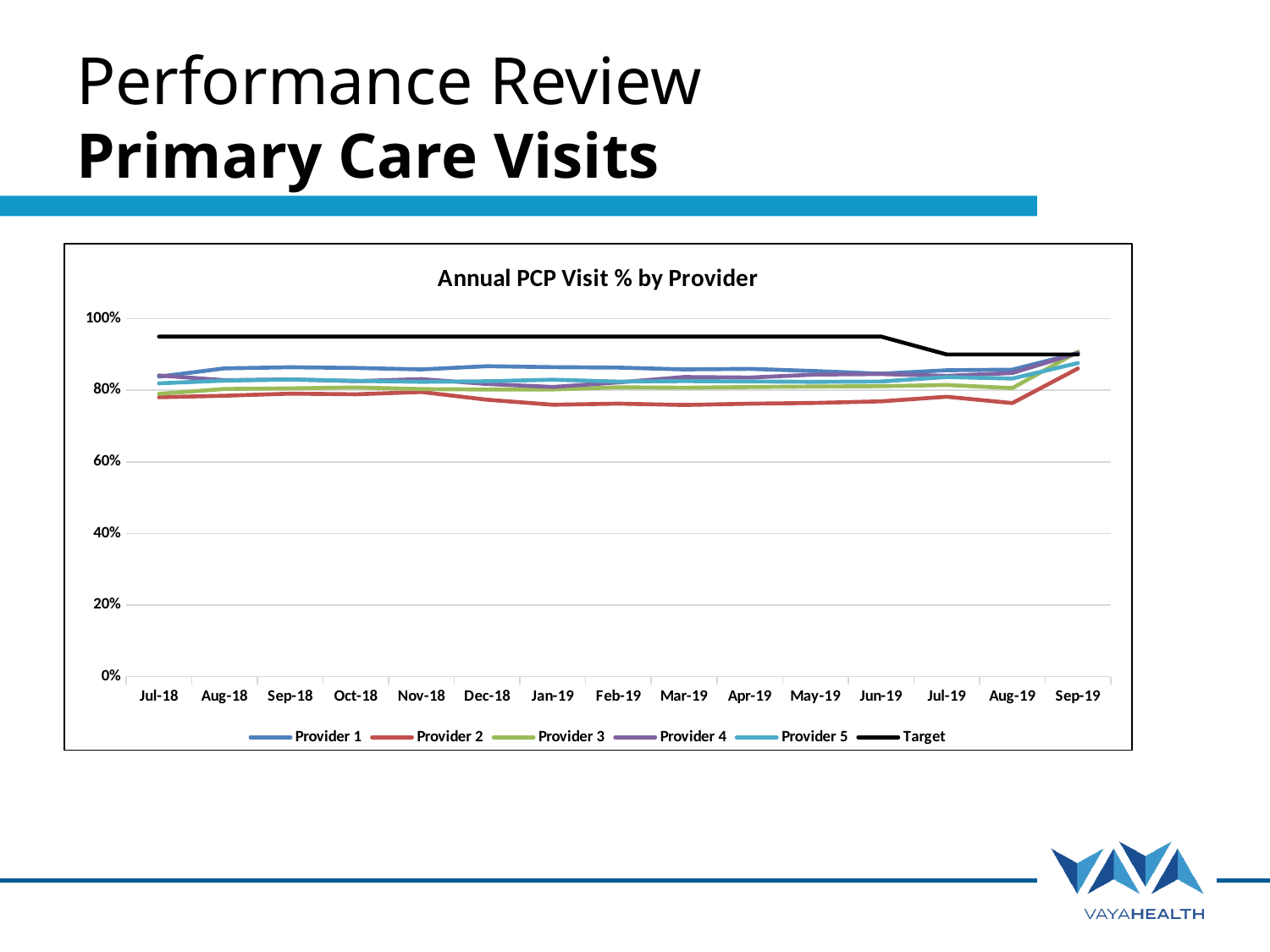
Which series has the lowest value in Jan-19? Provider 2 How many months are shown along the x axis? 15 What is the title of the chart? Annual PCP Visit % by Provider How many series does the legend list? 6 Is the value for Target in Jul-18 greater or less than 80%? greater Is the value for Provider 2 in Jan-19 greater or less than 80%? less In Jul-18, which is larger: the value for Target or the value for Provider 2? Target Which series is drawn as a black line? Target What kind of chart is shown on the slide? Line chart Is the value for Provider 2 in Aug-19 greater or less than 80%? less Does the Target line rise or fall from Jun-19 to Jul-19? Fall Which series has the highest value in Jul-18? Target